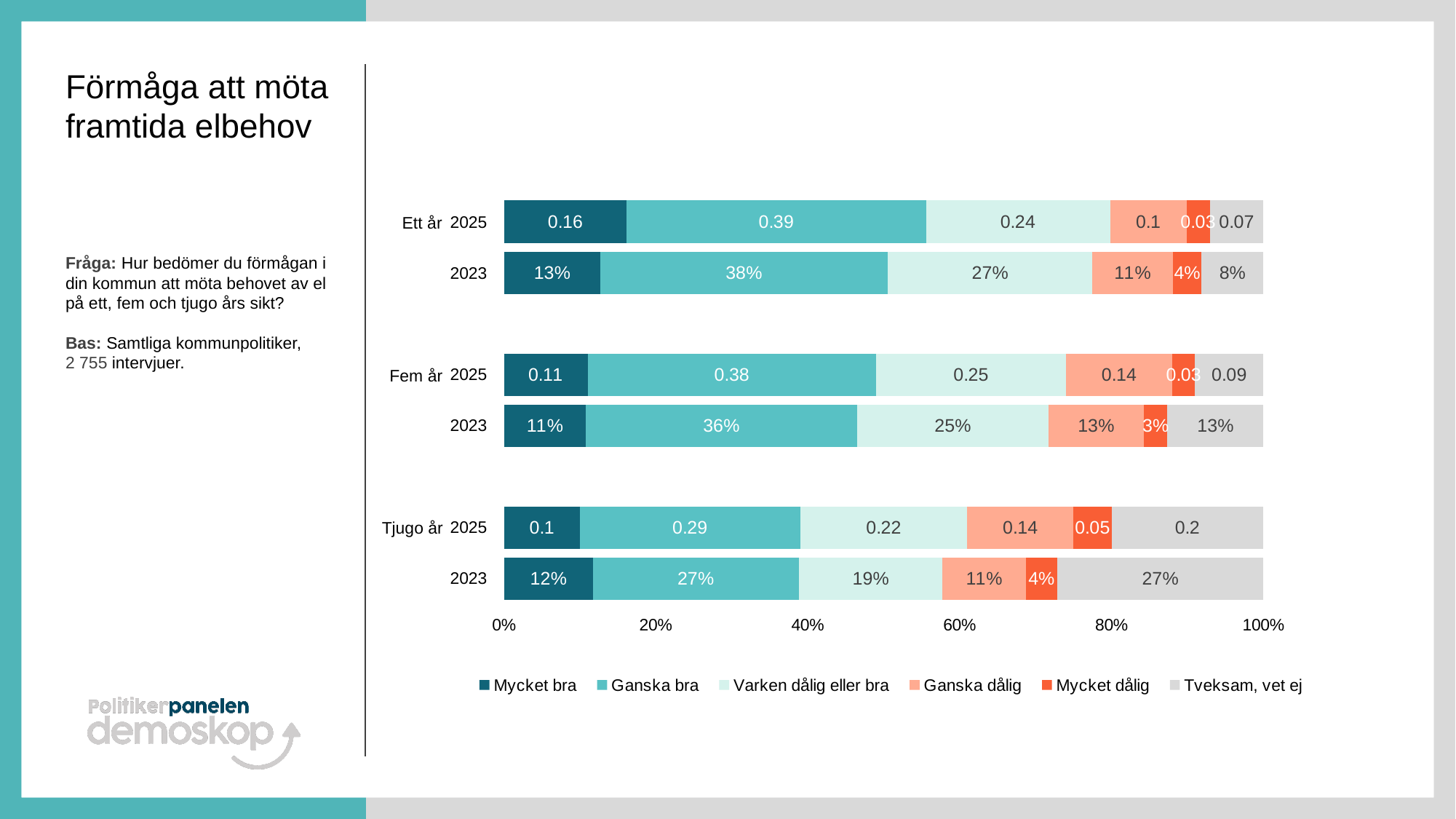
What kind of chart is shown on the slide? stacked bar chart What is the value for "Mycket bra" in the Ett år 2025 bar? 0.16 What is the difference between the "Tveksam, vet ej" values for Tjugo år 2023 and Ett år 2023? 19 percentage points Which segment is the smallest in the Fem år 2025 bar? Mycket dålig Which is larger: the "Ganska bra" value for Ett år 2025 or for Tjugo år 2025? Ett år 2025 What is the value for "Tveksam, vet ej" in the Tjugo år 2025 bar? 0.2 What is the value for "Ganska bra" in the Ett år 2023 bar? 38% How many bars are plotted in the chart? 6 What is the value for "Varken dålig eller bra" in the Fem år 2023 bar? 25% How many series does the legend list? 6 Which segment is the largest in the Tjugo år 2023 bar? Ganska bra and Tveksam, vet ej (both 27%) Which series is shown in the darkest teal colour in the legend? Mycket bra